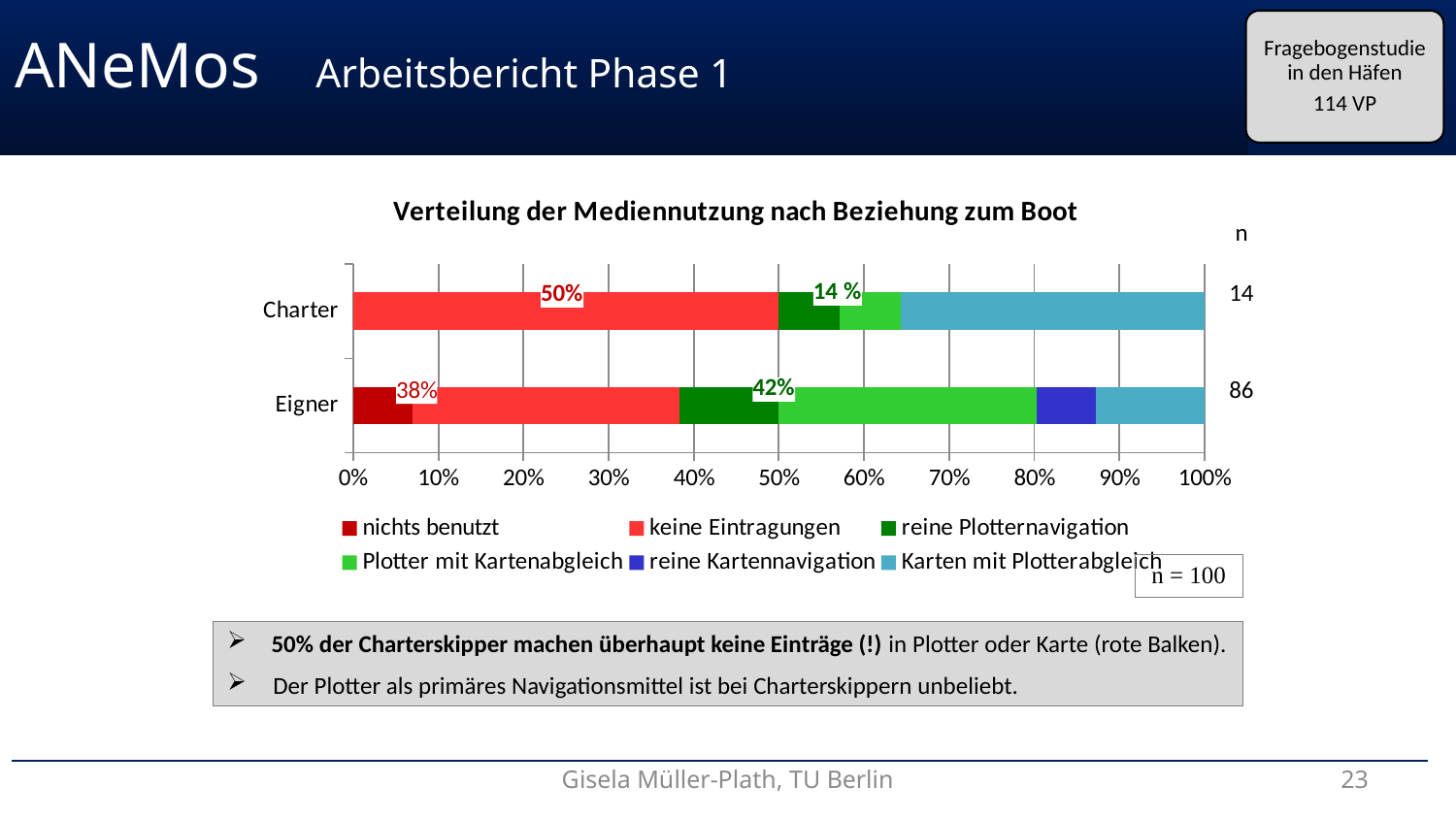
What red percentage label is printed on the Charter bar? 50% How many series does the legend list? 6 What is the difference between the red label on the Charter bar (50%) and the red label on the Eigner bar (38%)? 12 percentage points What is the n value shown for the Eigner bar? 86 What is the title of the chart? Verteilung der Mediennutzung nach Beziehung zum Boot Which category has the larger n value, Charter or Eigner? Eigner What type of chart is shown on the slide? Stacked bar chart What green percentage label is printed on the Eigner bar? 42% What is the n value shown for the Charter bar? 14 Is the share of 'Karten mit Plotterabgleich' in the Charter bar greater or less than 30%? greater How many categories (bars) does the chart show? 2 What red percentage label is printed on the Eigner bar? 38%